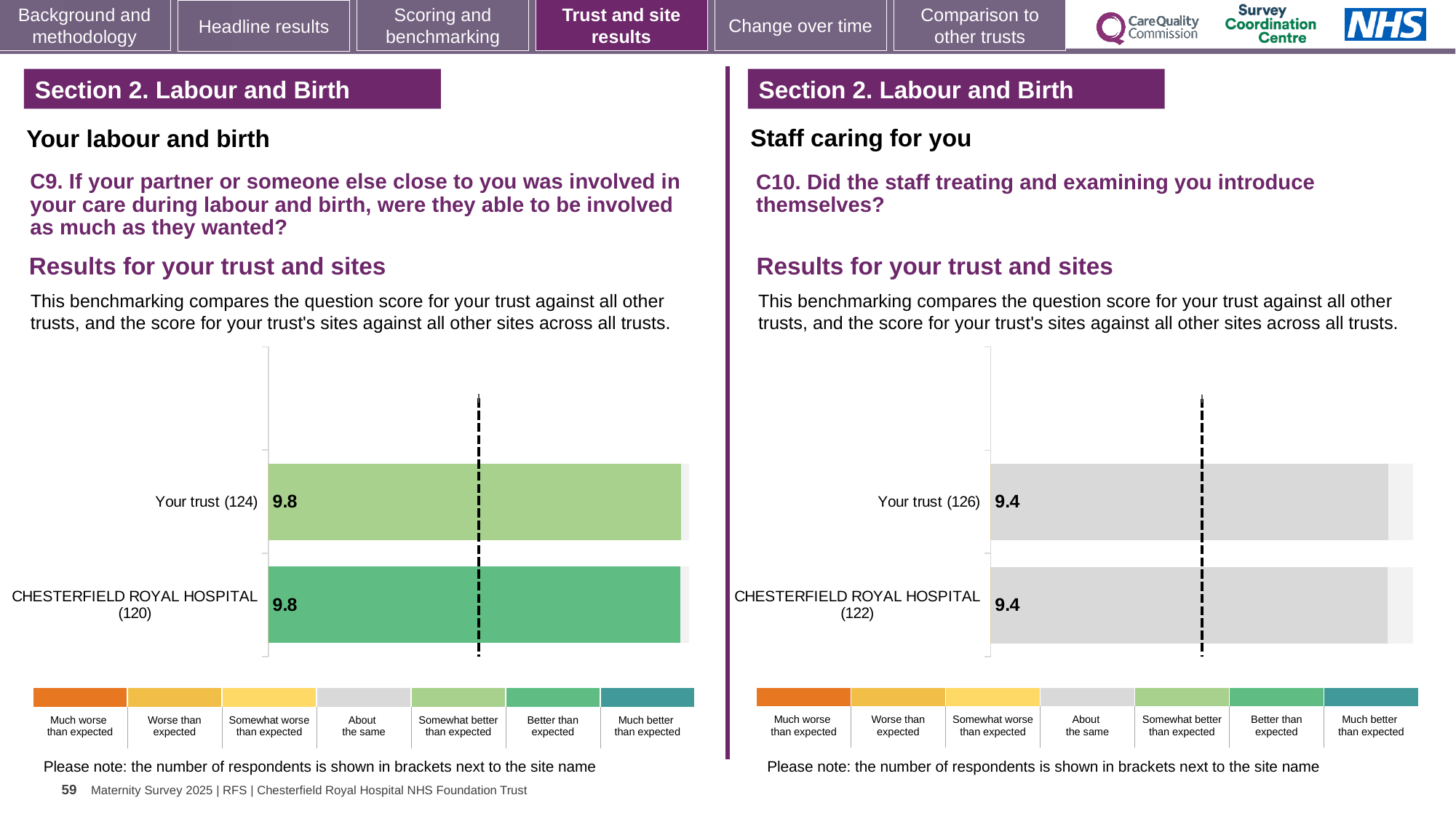
What kind of chart is the C9 chart on the left? Bar chart On the C9 chart on the left, what is the difference between the score for Your trust and the score for Chesterfield Royal Hospital? 0 On the C10 chart on the right, what is the difference between the score for Your trust and the score for Chesterfield Royal Hospital? 0 On the C9 chart on the left, what is the score for Chesterfield Royal Hospital? 9.8 On the C10 chart on the right, what is the score for Chesterfield Royal Hospital? 9.4 On the C9 chart on the left, how many respondents are shown in brackets for Your trust? 124 On the C9 chart on the left, what is the score for Your trust? 9.8 How many bars are plotted on the C10 chart on the right? 2 On the C10 chart on the right, what is the score for Your trust? 9.4 On the C10 chart on the right, how many respondents are shown in brackets for Chesterfield Royal Hospital? 122 How many bars are plotted on the C9 chart on the left? 2 Is the score for Your trust on the C10 chart on the right larger or smaller than the score for Your trust on the C9 chart on the left? Smaller